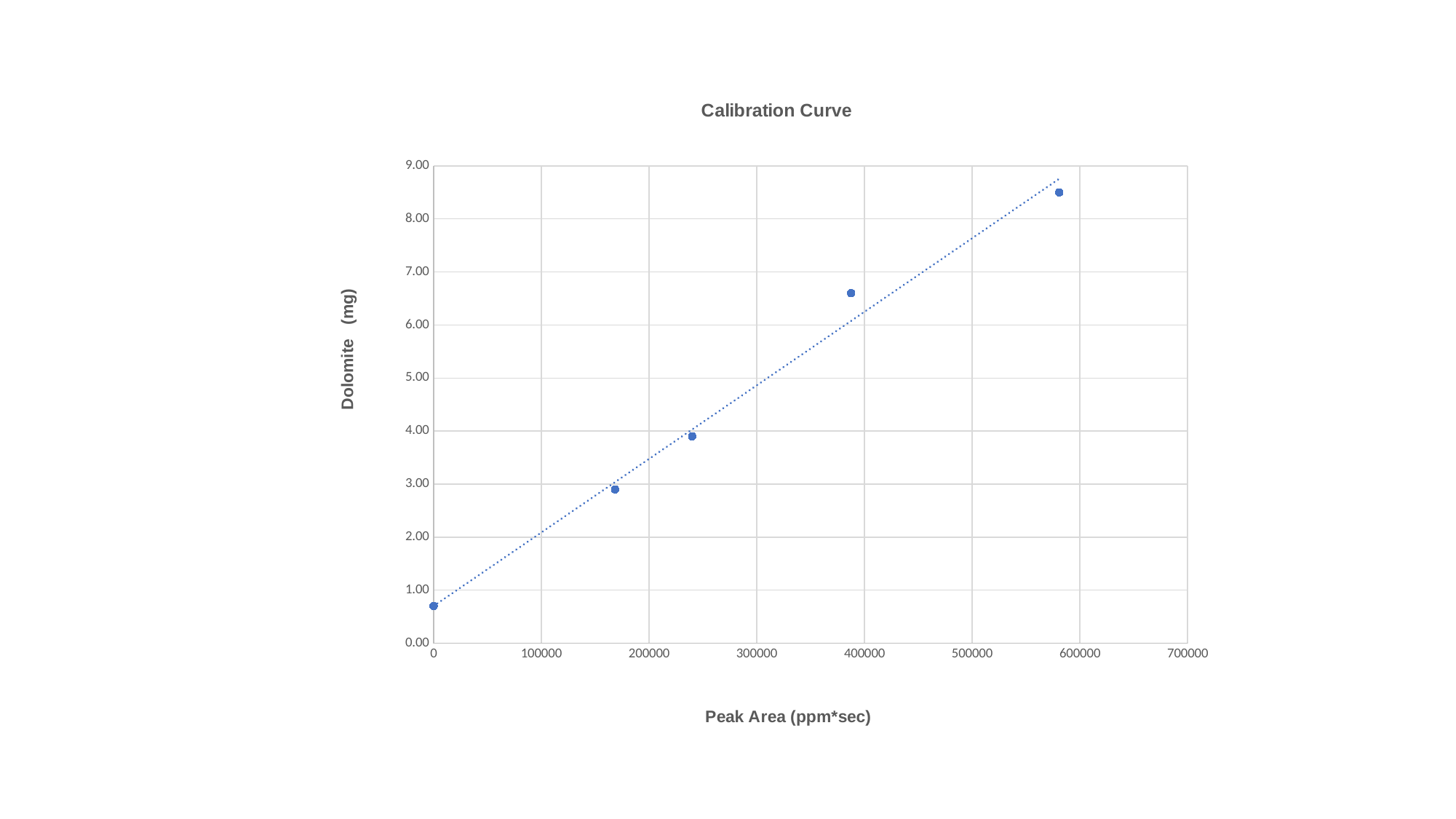
How many data points are plotted on the chart? 5 Is the Dolomite (mg) value of the rightmost data point greater or less than 8.00? greater Is the Dolomite (mg) value of the data point at Peak Area 0 greater or less than 1.00? less What is the maximum value shown on the y axis? 9.00 What is the title of the chart? Calibration Curve What kind of chart is shown on the slide? Scatter chart Which data point has the highest Dolomite (mg) value: the one near Peak Area 400000 or the one near Peak Area 600000? The one near Peak Area 600000 Is the Dolomite (mg) value of the data point near Peak Area 400000 greater or less than 6.00? greater Do the Dolomite (mg) values rise or fall as Peak Area increases along the x axis? Rise What is the label of the x axis? Peak Area (ppm*sec)